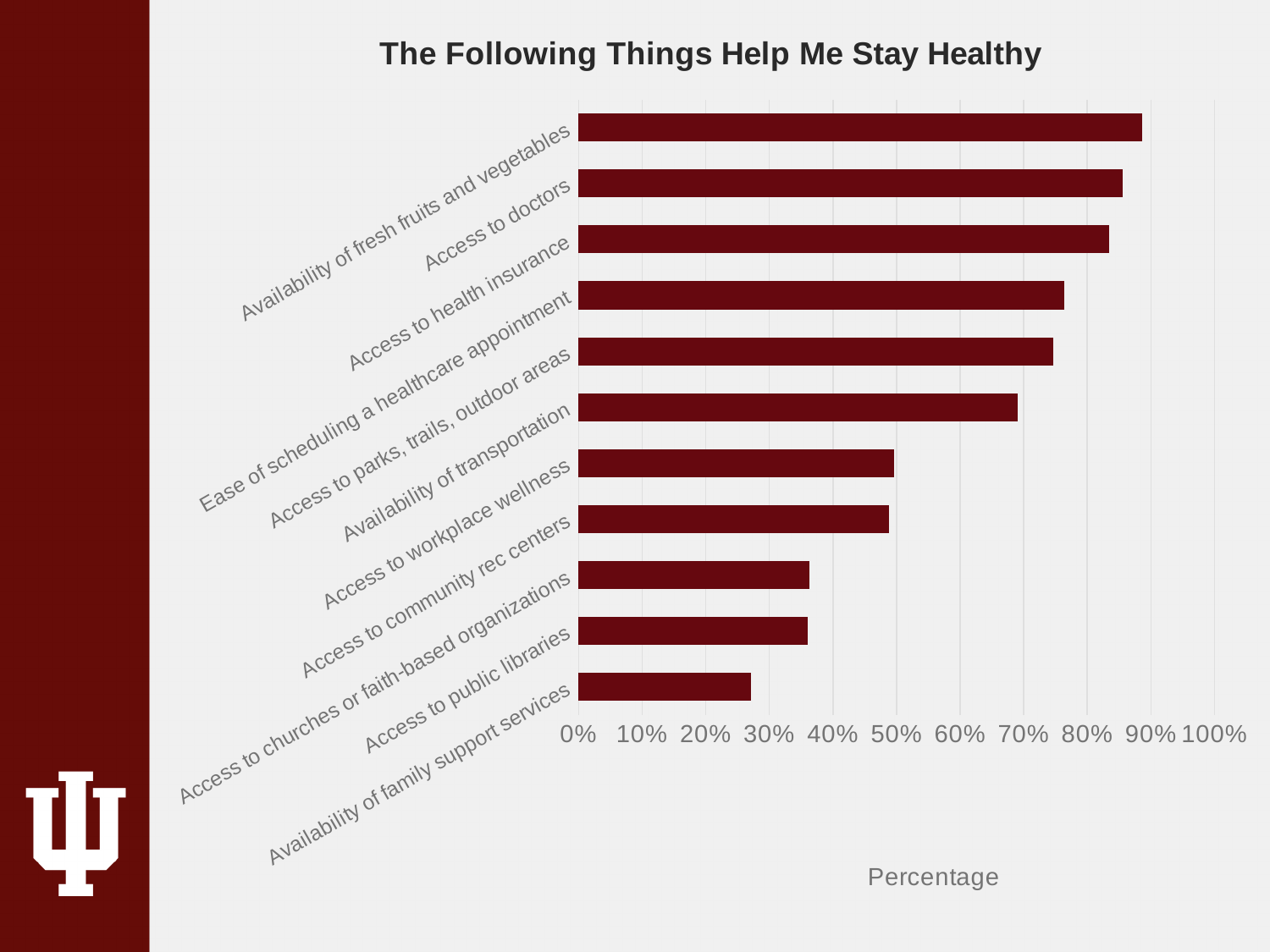
What is the title of the chart? The Following Things Help Me Stay Healthy Which is larger, the value for Access to workplace wellness or the value for Access to public libraries? Access to workplace wellness Which is larger, the value for Access to parks, trails, outdoor areas or the value for Access to community rec centers? Access to parks, trails, outdoor areas How many categories are plotted in the chart? 11 What is the label on the horizontal axis of the chart? Percentage Is the value for Availability of family support services greater or less than 30%? less Which category has the lowest value? Availability of family support services Is the value for Access to health insurance greater or less than 80%? greater What kind of chart is shown on the slide? bar chart Which category has the highest value? Availability of fresh fruits and vegetables Is the value for Access to doctors greater or less than 80%? greater